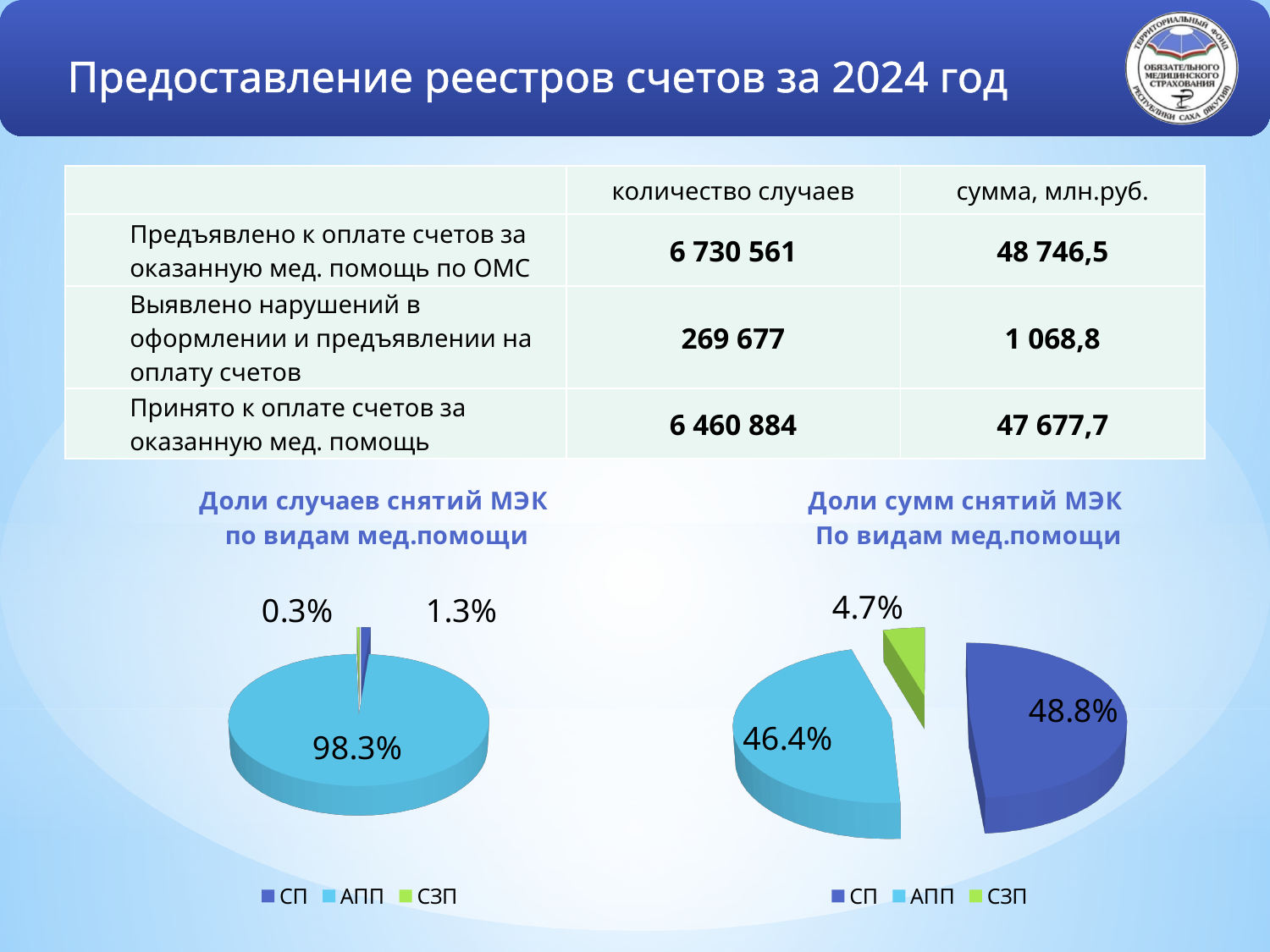
In the right pie chart 'Доли сумм снятий МЭК по видам мед.помощи', what is the difference between the shares of СП and АПП? 2.4% In the right pie chart 'Доли сумм снятий МЭК по видам мед.помощи', what share does СЗП have? 4.7% How many categories does the legend of the right pie chart 'Доли сумм снятий МЭК по видам мед.помощи' list? 3 In the right pie chart 'Доли сумм снятий МЭК по видам мед.помощи', what colour is the СЗП slice? green In the right pie chart 'Доли сумм снятий МЭК по видам мед.помощи', which category has the smallest share? СЗП In the left pie chart 'Доли случаев снятий МЭК по видам мед.помощи', which category has the largest share? АПП What kind of chart is used for 'Доли случаев снятий МЭК по видам мед.помощи'? pie chart How many slices does the left pie chart 'Доли случаев снятий МЭК по видам мед.помощи' have? 3 In the left pie chart 'Доли случаев снятий МЭК по видам мед.помощи', what is the smallest share shown? 0.3% In the left pie chart 'Доли случаев снятий МЭК по видам мед.помощи', what share does АПП have? 98.3% In the right pie chart 'Доли сумм снятий МЭК по видам мед.помощи', what share does АПП have? 46.4%